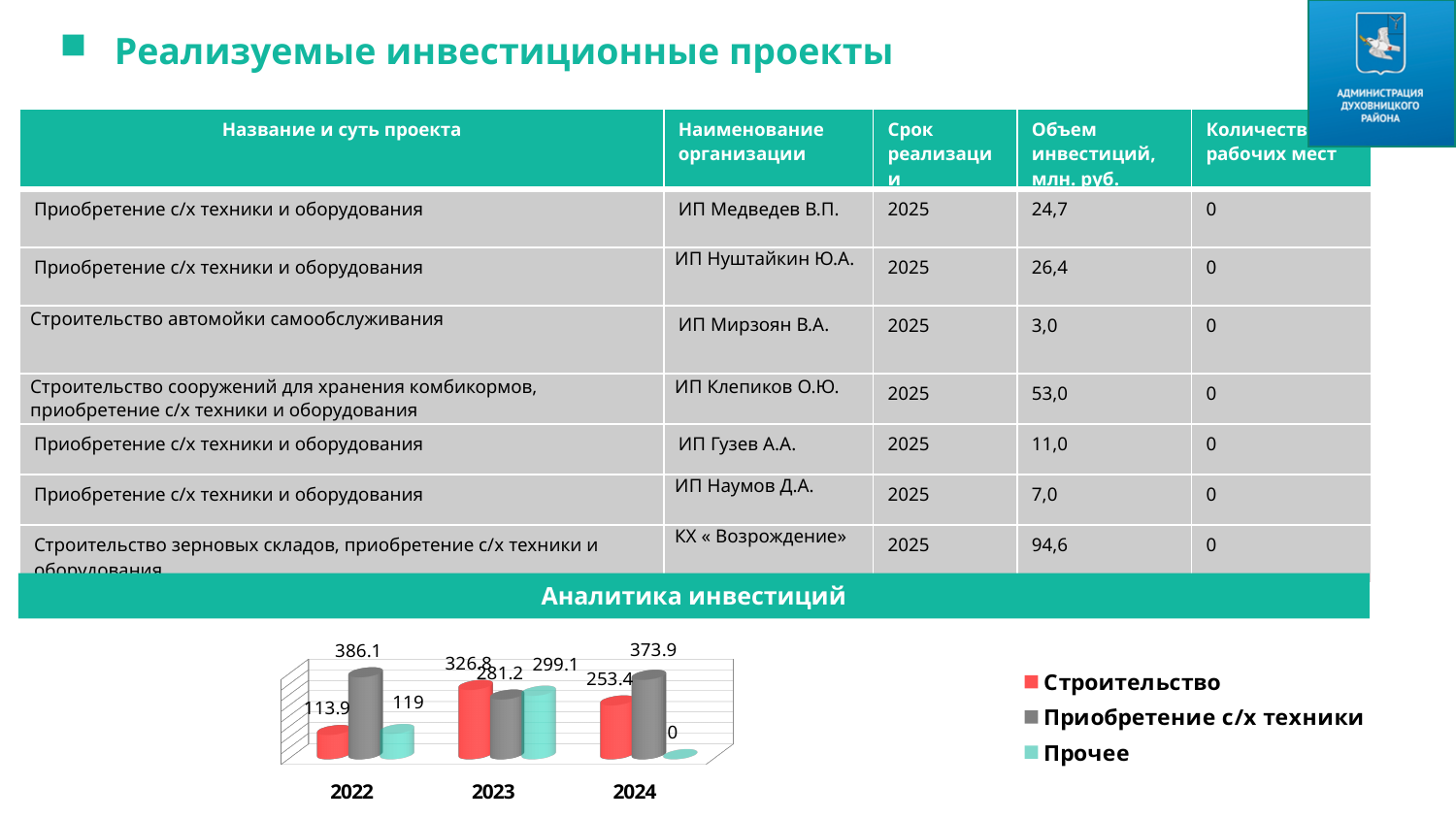
How many years are shown on the x axis of the chart? 3 How many series does the chart legend list? 3 In which year is the value for Приобретение с/х техники highest? 2022 What kind of chart is shown under the heading Аналитика инвестиций? Bar chart Which colour represents Прочее in the chart legend? Teal (light green) What is the value for Приобретение с/х техники in 2024? 373.9 In which year is the value for Строительство lowest? 2022 What is the value for Строительство in 2022? 113.9 Which is larger in 2023: Строительство or Приобретение с/х техники? Строительство What is the value for Прочее in 2024? 0 What is the value for Прочее in 2023? 299.1 What is the difference between Приобретение с/х техники and Строительство in 2022? 272.2